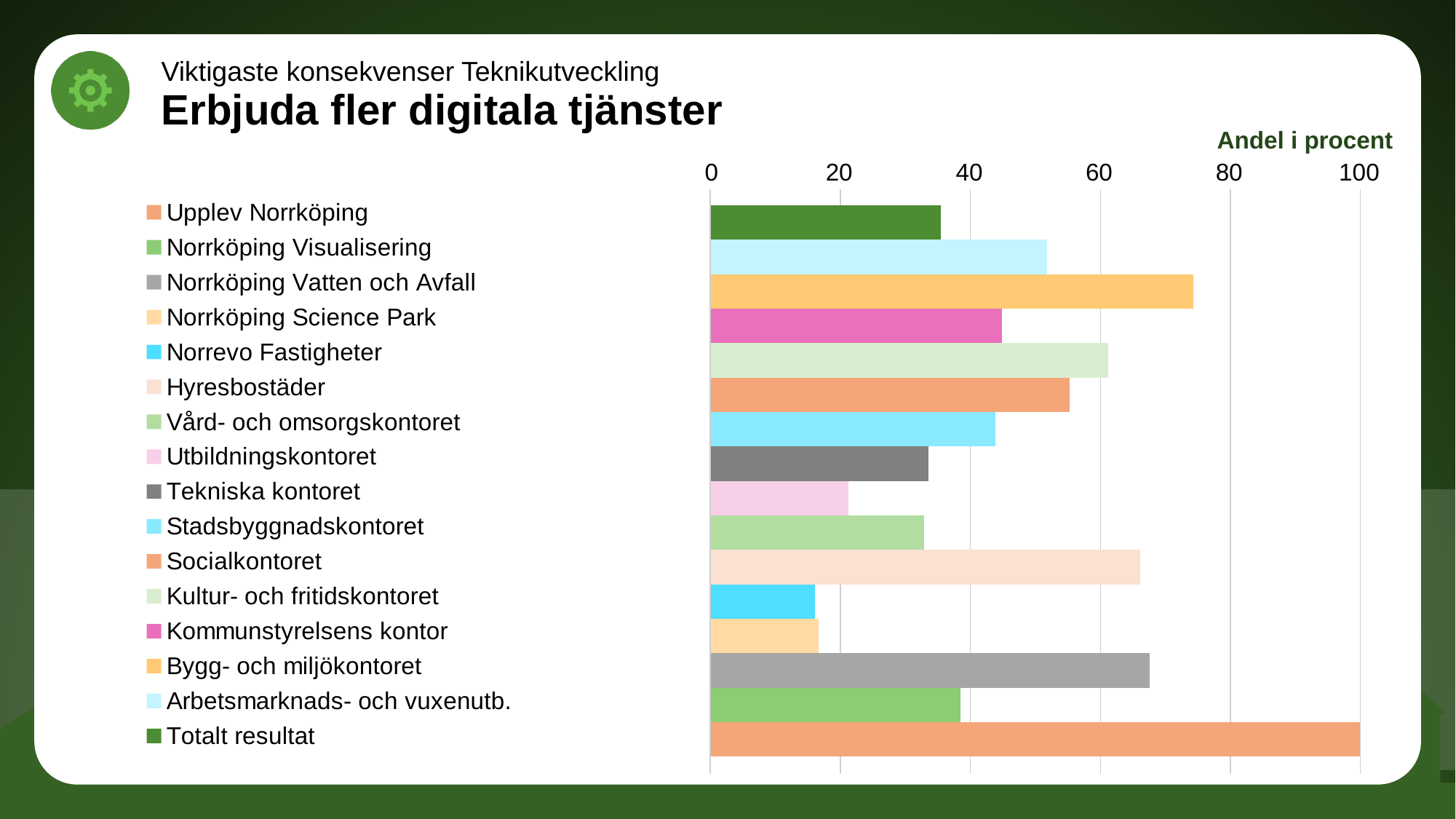
What label is shown above the horizontal axis of the chart? Andel i procent What kind of chart is shown on the slide? bar chart Which is larger, the value for Hyresbostäder or the value for Utbildningskontoret? Hyresbostäder Is the value for Utbildningskontoret greater or less than 40? less How many entries does the legend list? 16 Which is larger, the value for Bygg- och miljökontoret or the value for Totalt resultat? Bygg- och miljökontoret Is the value for Bygg- och miljökontoret greater or less than 60? greater Is the value for Totalt resultat greater or less than 40? less What is the value for Upplev Norrköping? 100 Which category has the highest value in the chart? Upplev Norrköping What is the main title of the slide above the chart? Erbjuda fler digitala tjänster